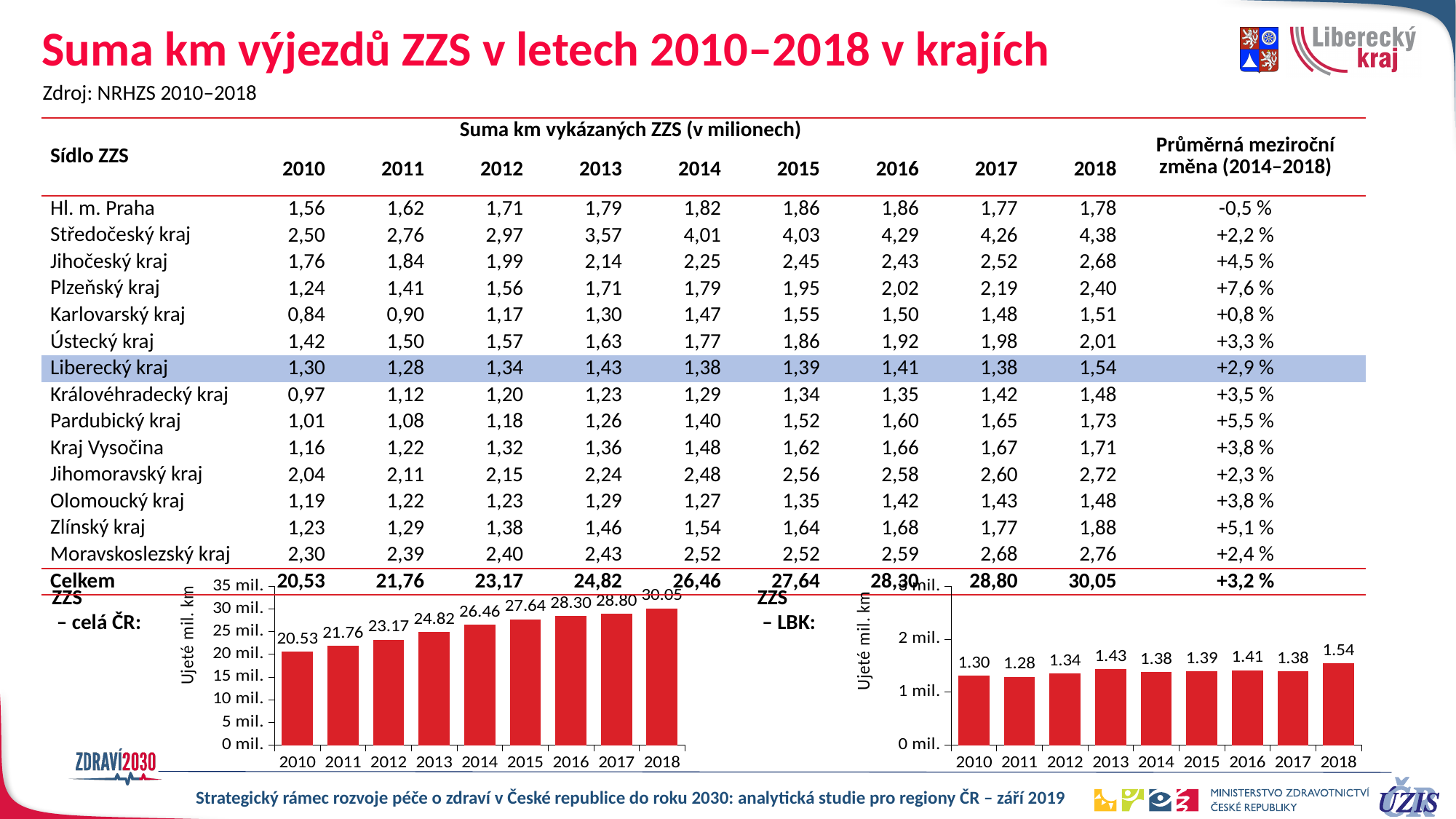
In the right chart (ZZS – LBK), what is the value for 2013? 1.43 In the left chart (ZZS – celá ČR), do the values rise or fall from 2010 to 2018? rise In the right chart (ZZS – LBK), which year has the lowest value? 2011 In the right chart (ZZS – LBK), which year has the highest value? 2018 In the left chart (ZZS – celá ČR), what is the value for 2010? 20.53 In the left chart (ZZS – celá ČR), which year has the highest value? 2018 In the left chart (ZZS – celá ČR), which year has the lowest value? 2010 How many bars are shown in the right chart (ZZS – LBK)? 9 In the left chart (ZZS – celá ČR), what is the value for 2018? 30.05 What type of chart is the left chart (ZZS – celá ČR)? bar chart In the right chart (ZZS – LBK), which is larger, the value for 2012 or the value for 2017? 2017 In the left chart (ZZS – celá ČR), what is the difference between the values for 2018 and 2010? 9.52